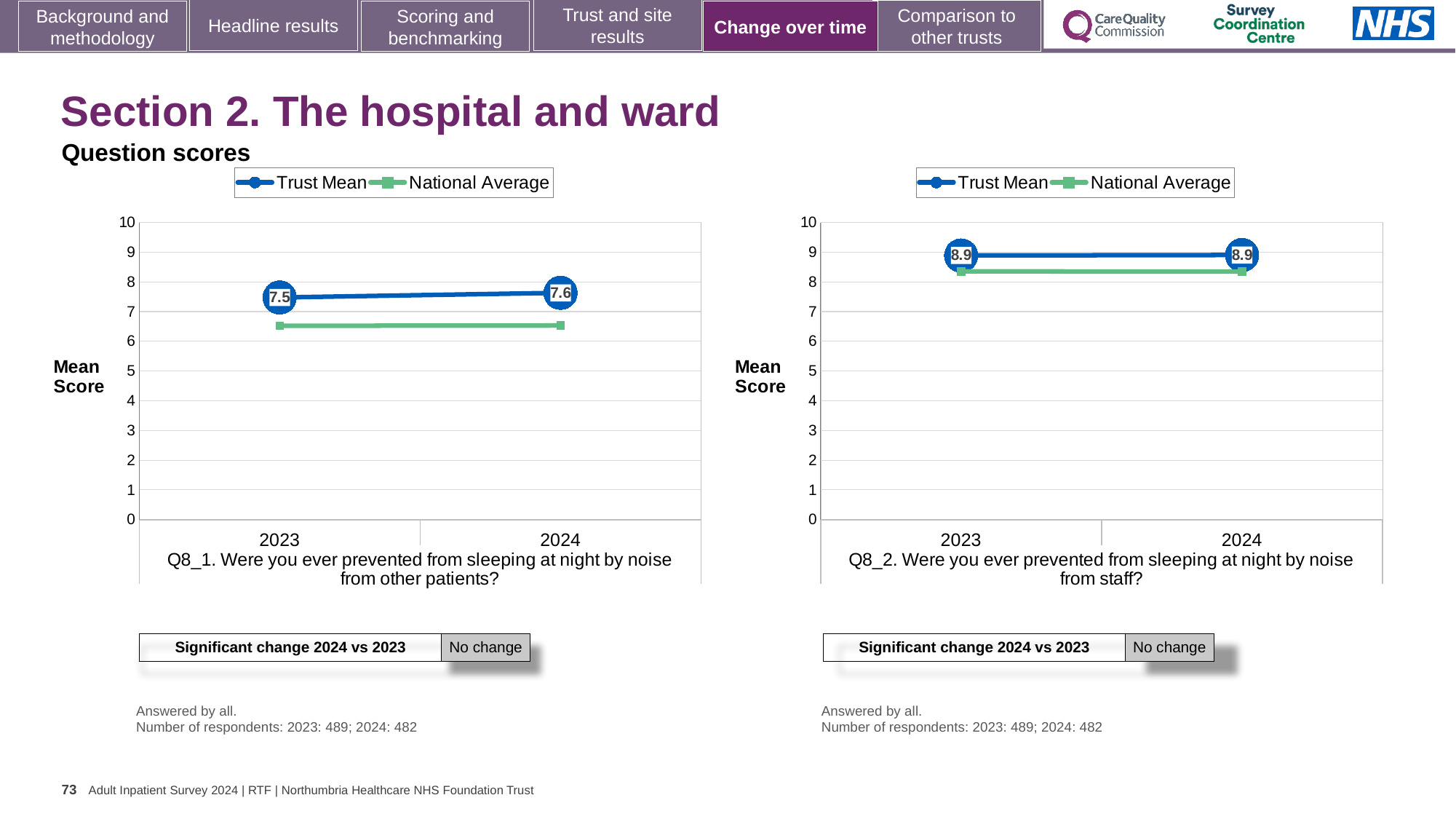
How many years are plotted on the x axis of the right chart (Q8_2)? 2 In the right chart (Q8_2), does the Trust Mean rise, fall or stay the same from 2023 to 2024? stays the same What kind of chart is the left chart (Q8_1)? line chart In the left chart (Q8_1), what is the Trust Mean score for 2023? 7.5 In the right chart (Q8_2), what is the Trust Mean score for 2024? 8.9 In the right chart (Q8_2), is the National Average for 2023 greater or less than 8? greater In the left chart (Q8_1), is the National Average for 2024 greater or less than 7? less In the left chart (Q8_1), what is the difference between the Trust Mean scores for 2024 and 2023? 0.1 How many series does the legend of the left chart (Q8_1) list? 2 In the left chart (Q8_1), does the Trust Mean rise or fall from 2023 to 2024? rise In the left chart (Q8_1), what is the Trust Mean score for 2024? 7.6 In the right chart (Q8_2), which is larger in 2024, the Trust Mean or the National Average? Trust Mean